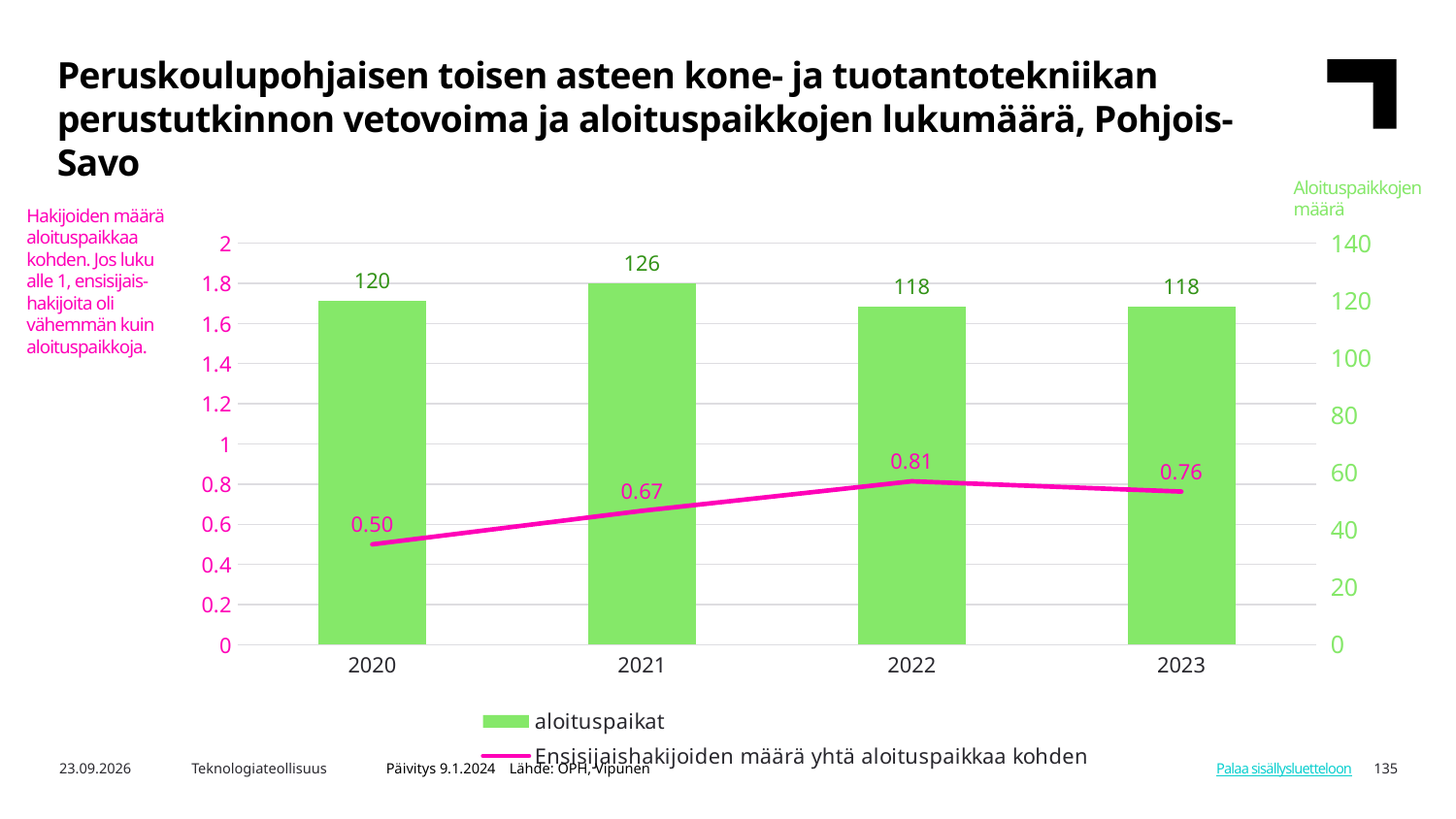
What is the value of Ensisijaishakijoiden määrä yhtä aloituspaikkaa kohden for 2020? 0.50 Does the Ensisijaishakijoiden määrä yhtä aloituspaikkaa kohden line rise or fall from 2020 to 2022? rise Which year has the lowest value of Ensisijaishakijoiden määrä yhtä aloituspaikkaa kohden? 2020 How many series does the legend list? 2 What is the difference between the aloituspaikat values for 2021 and 2020? 6 Which year has the highest value of aloituspaikat? 2021 How many years are shown on the x axis? 4 Is the aloituspaikat value for 2023 greater or less than 100? greater What is the value of Ensisijaishakijoiden määrä yhtä aloituspaikkaa kohden for 2022? 0.81 What colour are the aloituspaikat bars? green Which is larger, the Ensisijaishakijoiden määrä yhtä aloituspaikkaa kohden value for 2022 or for 2023? 2022 What is the value of aloituspaikat for 2021? 126